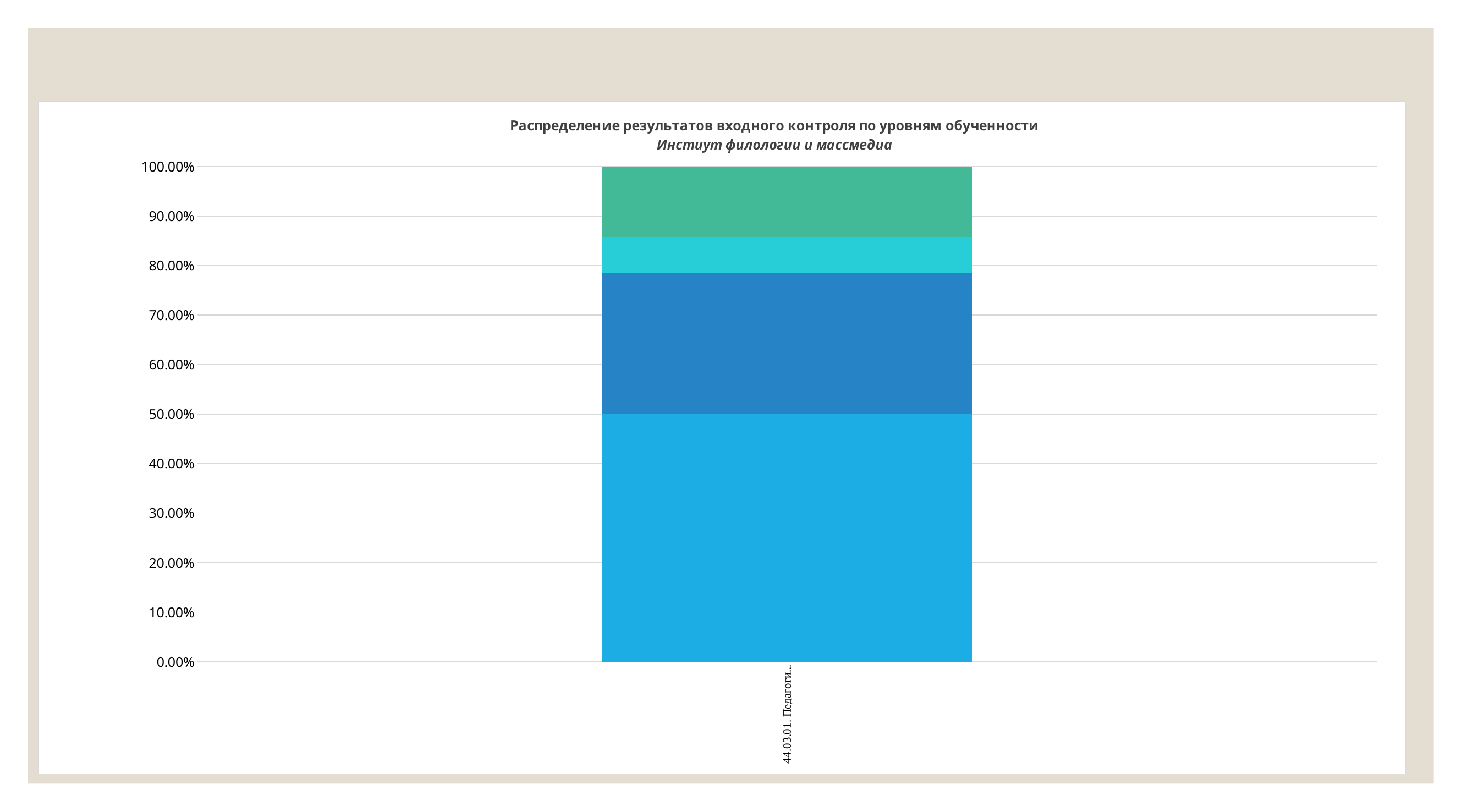
What value does the bottom (light blue) segment of the stacked bar reach on the y axis? 50.00% How many stacked segments make up the bar for the category "44.03.01. Педагоги..."? 4 Which segment of the stacked bar is the largest? The bottom light blue segment How many categories are plotted along the x axis of the chart? 1 Is the cyan segment of the stacked bar greater or less than 10.00%? less What kind of chart is shown on the slide? Stacked bar chart Which segment of the stacked bar is the smallest? The cyan segment What is the main title of the chart? Распределение результатов входного контроля по уровням обученности Is the bottom (light blue) segment of the stacked bar greater or less than 40.00%? greater Is the top (green) segment of the stacked bar greater or less than 20.00%? less What is the total height of the stacked bar for "44.03.01. Педагоги..."? 100.00% Which is larger: the dark blue segment or the green segment of the stacked bar? The dark blue segment